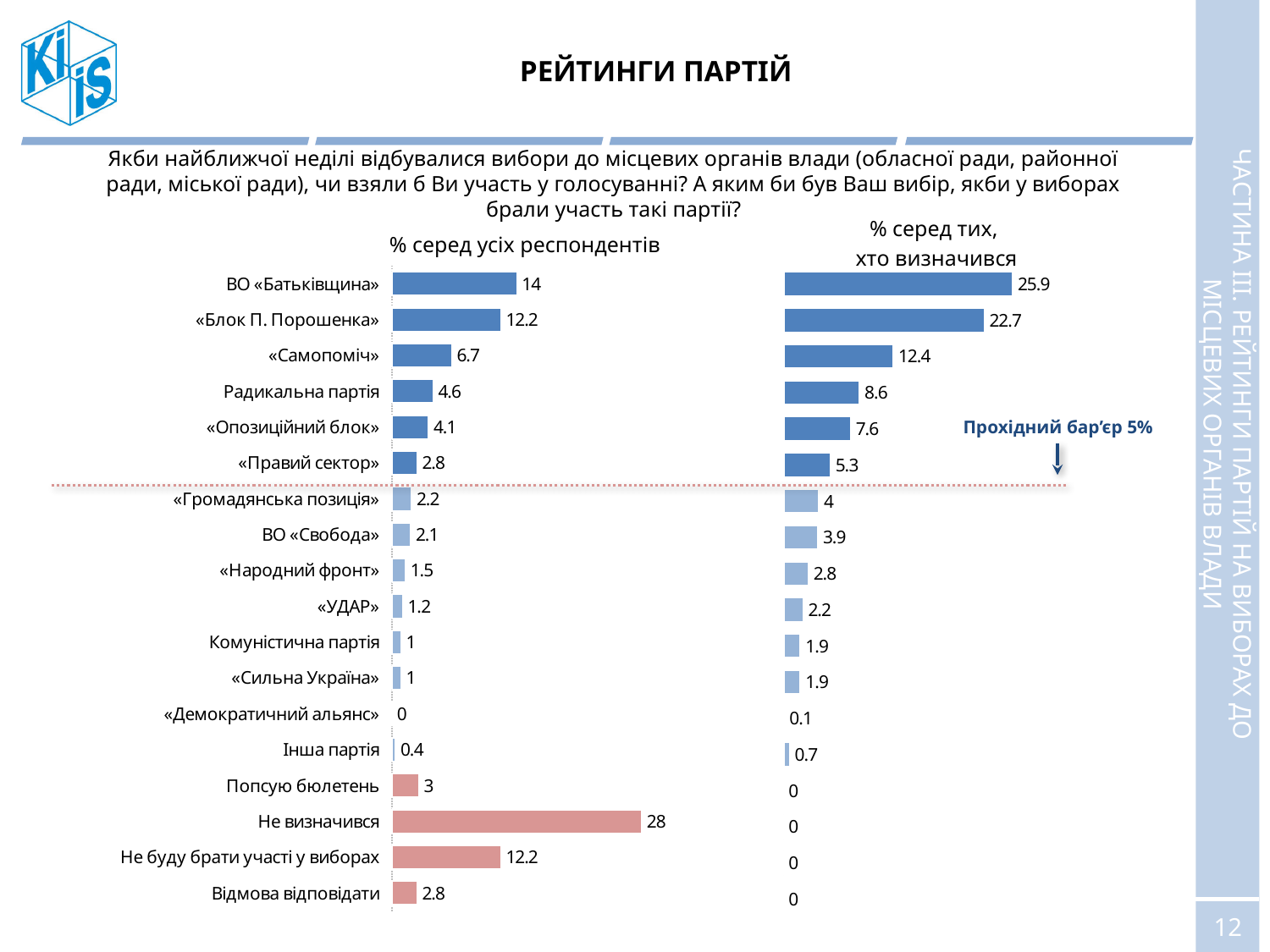
What threshold is marked by the dashed line and the label on the right chart? Прохідний бар’єр 5% In the chart "% серед усіх респондентів", what is the value for «Демократичний альянс»? 0 In the chart "% серед тих, хто визначився", which is larger: «Опозиційний блок» or «Правий сектор»? «Опозиційний блок» What type of chart is used on this slide? Bar chart In the chart "% серед усіх респондентів", what is the value for Не визначився? 28 In the chart "% серед тих, хто визначився", what is the difference between «Самопоміч» and Радикальна партія? 3.8 In the chart "% серед тих, хто визначився", which party has the highest value? ВО «Батьківщина» In the chart "% серед усіх респондентів", what is the value for ВО «Батьківщина»? 14 In the chart "% серед тих, хто визначився", what is the value for «Правий сектор»? 5.3 In the chart "% серед усіх респондентів", which category has the highest value? Не визначився In the chart "% серед усіх респондентів", what is the difference between ВО «Батьківщина» and «Блок П. Порошенка»? 1.8 In the chart "% серед тих, хто визначився", what is the value for «Блок П. Порошенка»? 22.7